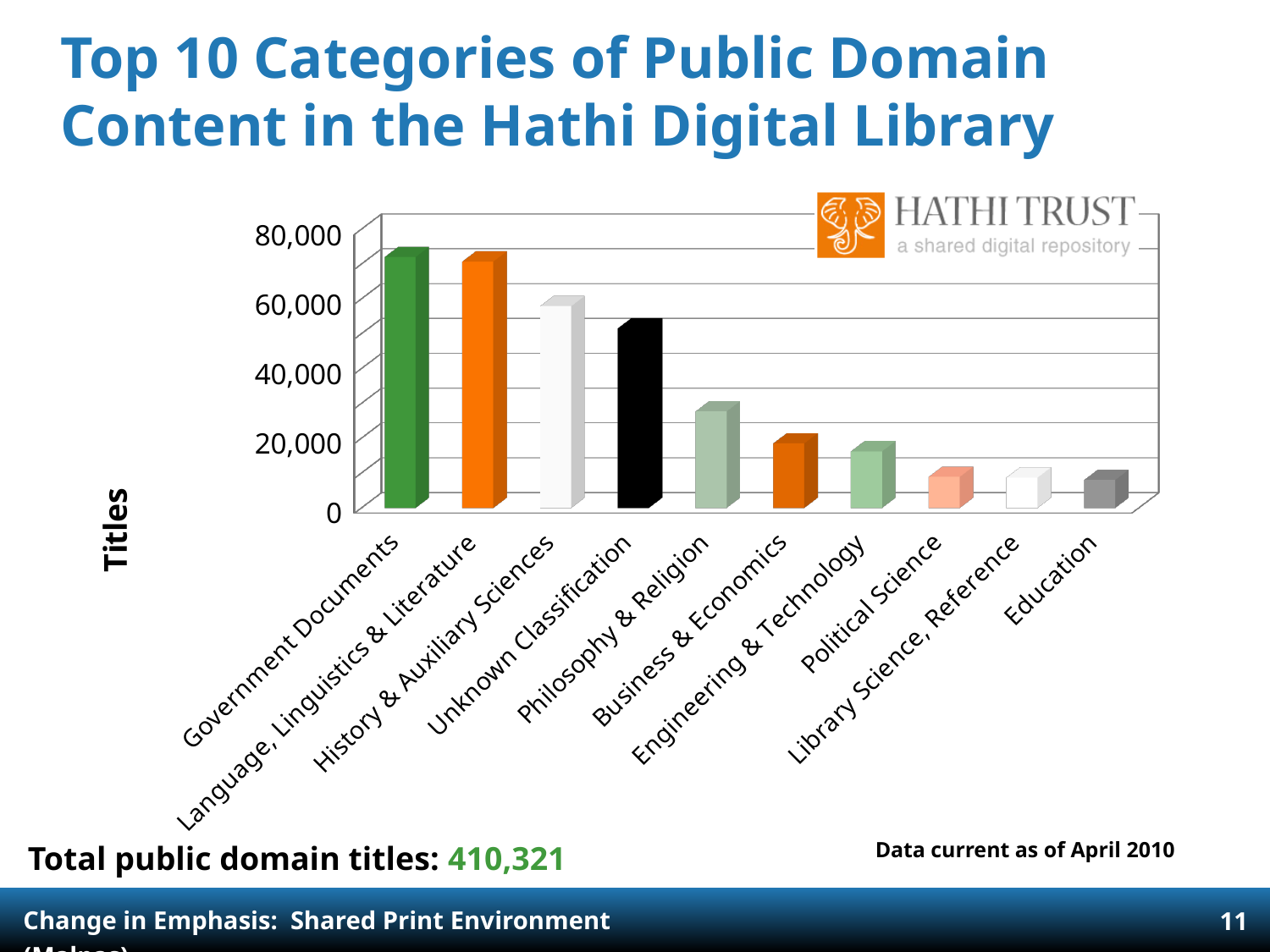
What is the total number of public domain titles stated on the slide? 410,321 Is the value for Government Documents greater or less than 60,000? greater Is the value for Education greater or less than 20,000? less Is the value for Unknown Classification greater or less than 40,000? greater Which has a larger value, Government Documents or Philosophy & Religion? Government Documents How many categories are plotted in the chart? 10 What kind of chart is shown on the slide? Bar chart What is the label on the vertical axis of the chart? Titles Which has a larger value, Philosophy & Religion or Business & Economics? Philosophy & Religion Do the values rise or fall moving from left to right along the x axis? Fall